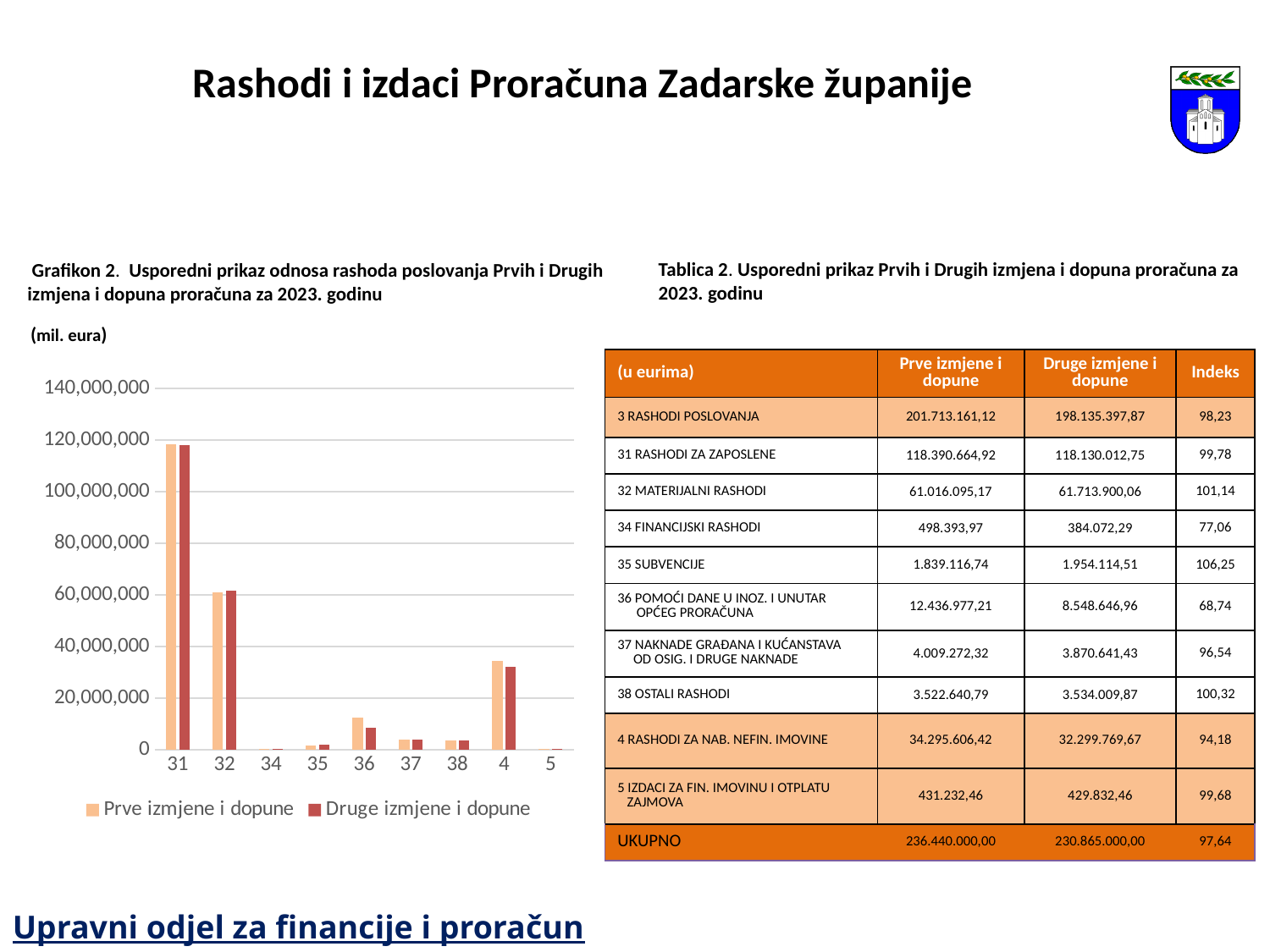
Is the value for category 4 in the series Druge izmjene i dopune greater or less than 40,000,000? less How many series does the chart legend list? 2 What unit is stated above the chart? (mil. eura) Which category has the highest value for the series Druge izmjene i dopune? 31 Is the value for category 31 in the series Prve izmjene i dopune greater or less than 100,000,000? greater What kind of chart is shown on the slide? bar chart What are the two legend entries of the chart? Prve izmjene i dopune; Druge izmjene i dopune How many categories are shown on the x axis of the chart? 9 Which category has the highest value for the series Prve izmjene i dopune? 31 For category 36, which series has the larger value: Prve izmjene i dopune or Druge izmjene i dopune? Prve izmjene i dopune Is the value for category 36 in the series Prve izmjene i dopune greater or less than 20,000,000? less Which is larger for the series Prve izmjene i dopune: category 32 or category 4? 32